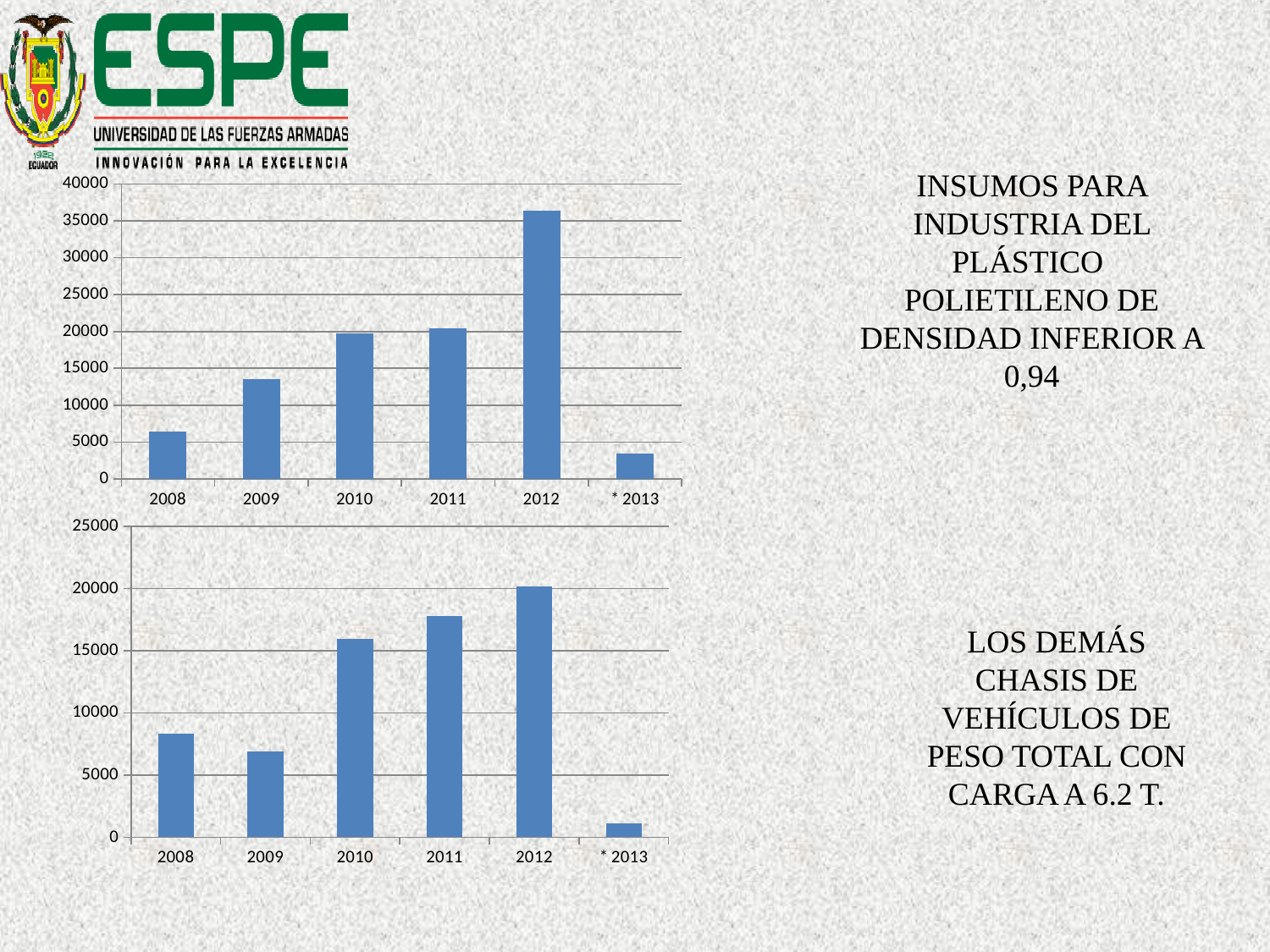
In the top chart, is the value for 2009 greater or less than 10000? greater What kind of chart is the bottom chart? bar chart In the top chart, which year has the highest bar? 2012 In the bottom chart, which is larger, the value for 2008 or the value for 2009? 2008 In the top chart, which is larger, the value for 2009 or the value for 2012? 2012 In the top chart, which category has the lowest bar? * 2013 In the bottom chart, which year has the highest bar? 2012 In the top chart, is the value for 2012 greater or less than 35000? greater In the bottom chart, which category has the lowest bar? * 2013 In the top chart, is the value for 2008 greater or less than 10000? less How many categories are shown on the x axis of the top chart? 6